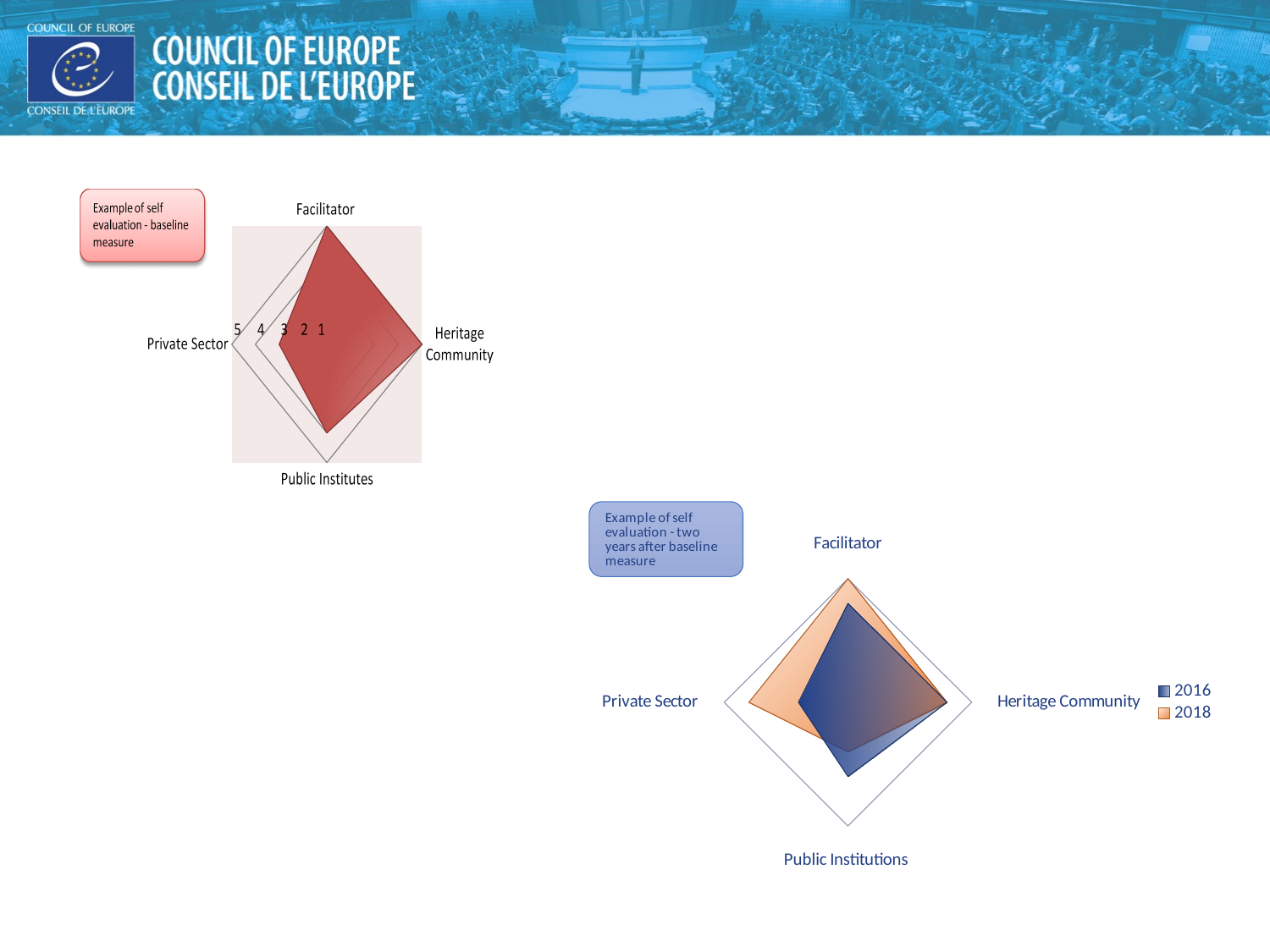
What kind of chart is the 'Example of self evaluation - baseline measure' chart? Radar chart In the 'Example of self evaluation - two years after baseline measure' chart, which series is larger for Private Sector, 2016 or 2018? 2018 In the 'Example of self evaluation - two years after baseline measure' chart, which series is larger for Public Institutions, 2016 or 2018? 2016 How many categories (axes) does the 'Example of self evaluation - two years after baseline measure' chart have? 4 In the 'Example of self evaluation - baseline measure' chart, is the value for Private Sector greater or less than 4? less In the 'Example of self evaluation - baseline measure' chart, what is the highest value shown on the axis scale? 5 In the 'Example of self evaluation - two years after baseline measure' chart, which years are listed in the legend? 2016 and 2018 What kind of chart is the 'Example of self evaluation - two years after baseline measure' chart? Radar chart How many categories (axes) does the 'Example of self evaluation - baseline measure' chart have? 4 How many series does the legend of the 'Example of self evaluation - two years after baseline measure' chart list? 2 In the 'Example of self evaluation - baseline measure' chart, is the value for Facilitator greater or less than 4? greater In the 'Example of self evaluation - two years after baseline measure' chart, which series is larger for Facilitator, 2016 or 2018? 2018